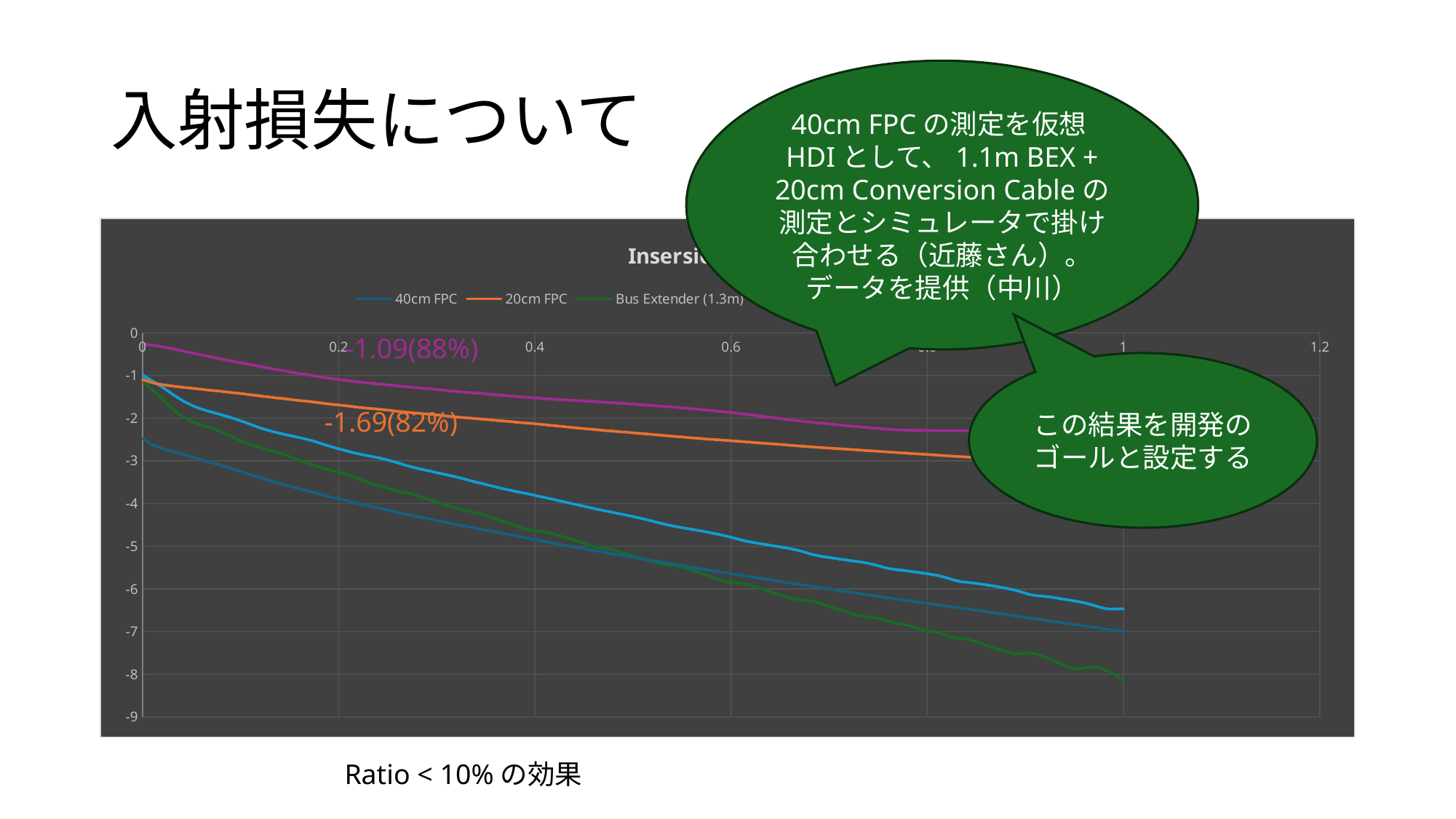
What kind of chart is shown on the slide? line chart At x = 1, which line has the higher value, 20cm FPC or 40cm FPC? 20cm FPC Do the values of the 40cm FPC line rise or fall as x increases? fall What is the largest tick value shown on the x axis? 1.2 What value annotation is printed in magenta text on the chart? -1.09(88%) What value annotation is printed in orange text on the chart? -1.69(82%) Which of the labelled series reaches the lowest value at x = 1? Bus Extender (1.3m) At x = 1, which line has the higher value, 40cm FPC or Bus Extender (1.3m)? 40cm FPC What colour is the 40cm FPC line in the legend? blue Is the value of the 20cm FPC line at x = 1 greater or less than -2? less Is the value of the Bus Extender (1.3m) line at x = 1 greater or less than -7? less